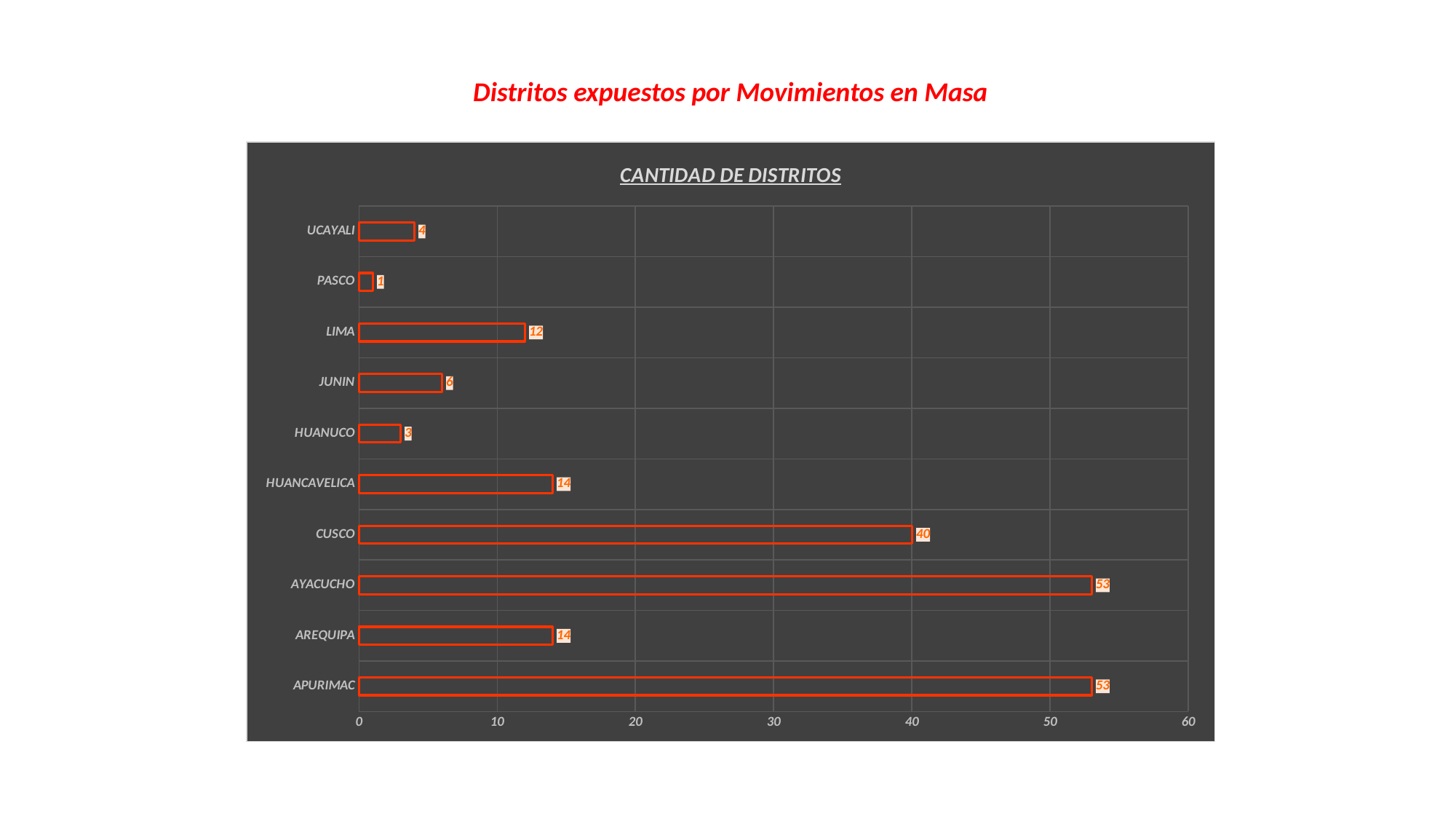
Is the value for CUSCO greater or less than 30? greater What is the difference between the values for AYACUCHO and CUSCO? 13 What is the value for CUSCO? 40 Which category has the lowest value? PASCO What is the title of the chart? CANTIDAD DE DISTRITOS Which two categories share the highest value of 53? AYACUCHO and APURIMAC What is the value for LIMA? 12 What kind of chart is shown on the slide? bar chart What is the value for HUANUCO? 3 Which is larger, the value for LIMA or the value for UCAYALI? LIMA How many categories are shown in the chart? 10 What is the difference between the values for HUANCAVELICA and JUNIN? 8